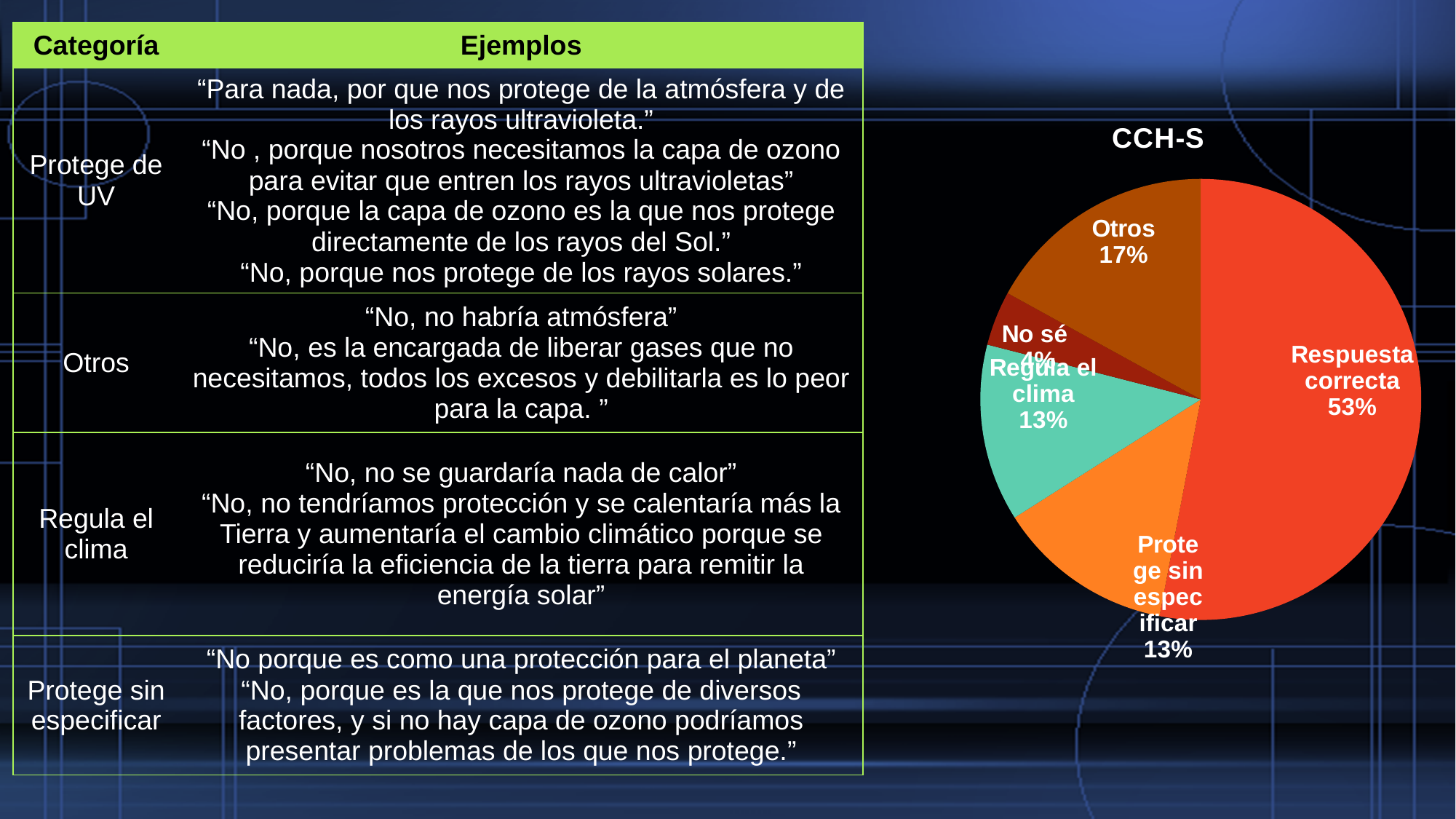
What share of the pie does "Otros" have? 17% What is the title of the pie chart? CCH-S What kind of chart is shown on the slide? pie chart Which slice is larger, "Otros" or "Regula el clima"? Otros What is the difference in percentage points between "Respuesta correcta" and "Otros"? 36 Which category has the largest slice of the pie? Respuesta correcta How many slices does the pie chart have? 5 What is the difference in percentage points between "Otros" and "No sé"? 13 Which category has the smallest slice of the pie? No sé What share of the pie does "Regula el clima" have? 13% What share of the pie does "No sé" have? 4%